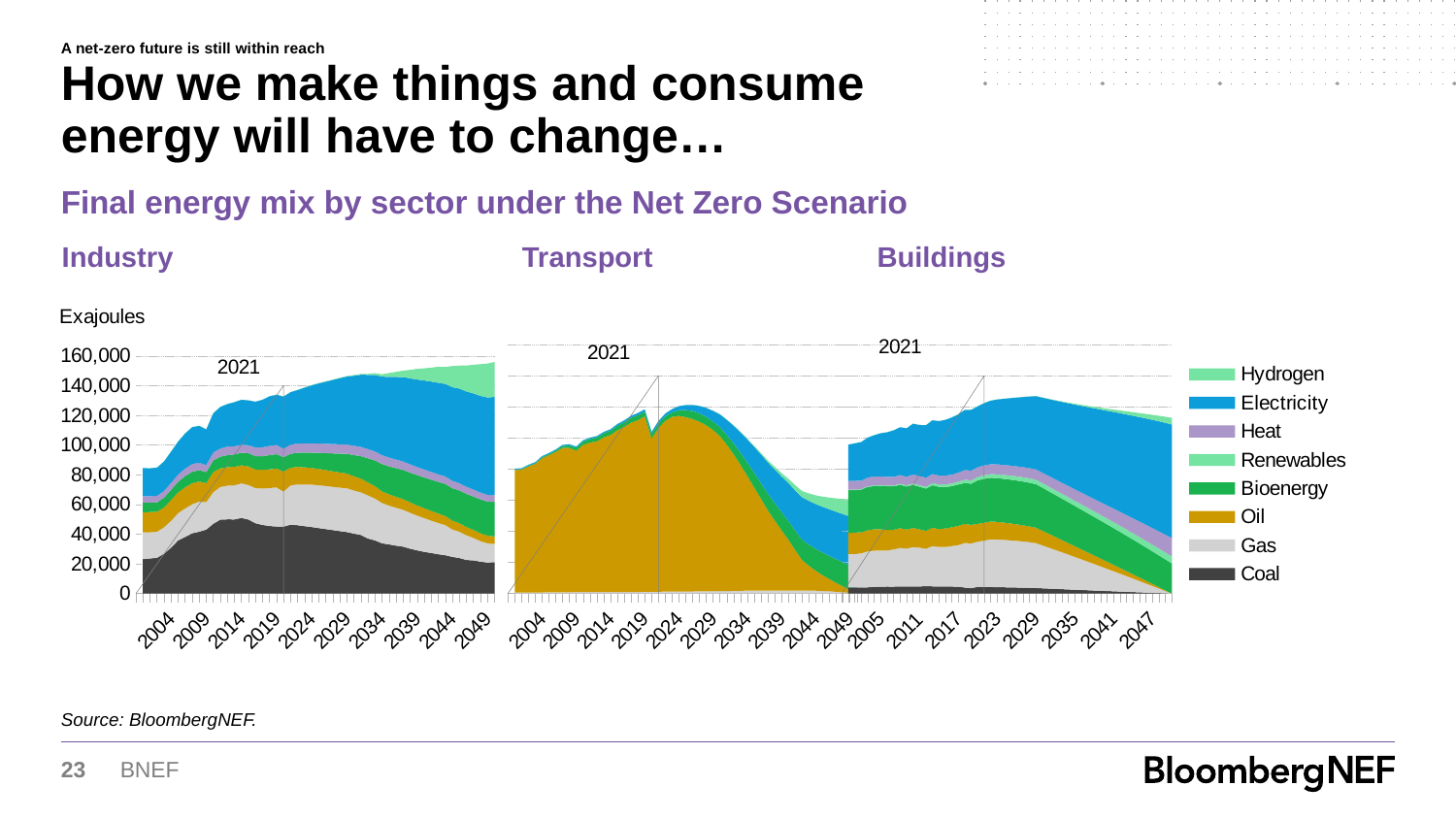
In the Transport chart, does the Oil series rise or fall between 2024 and 2049? fall In the Buildings chart, is the total value in 2029 greater or less than 100,000? greater How many series does the legend list? 8 What kind of chart is used for the Industry panel? Stacked area chart In the Transport chart, which series is largest in 2004? Oil How many sector charts are shown on the slide? 3 In the Transport chart, is the total value in 2049 greater or less than 80,000? less In the Industry chart, is the total value in 2049 greater or less than 140,000? greater What is the title of the chart group on the slide? Final energy mix by sector under the Net Zero Scenario In the Industry chart, does the Coal series rise or fall between 2014 and 2049? fall What unit is shown on the y axis of the charts? Exajoules